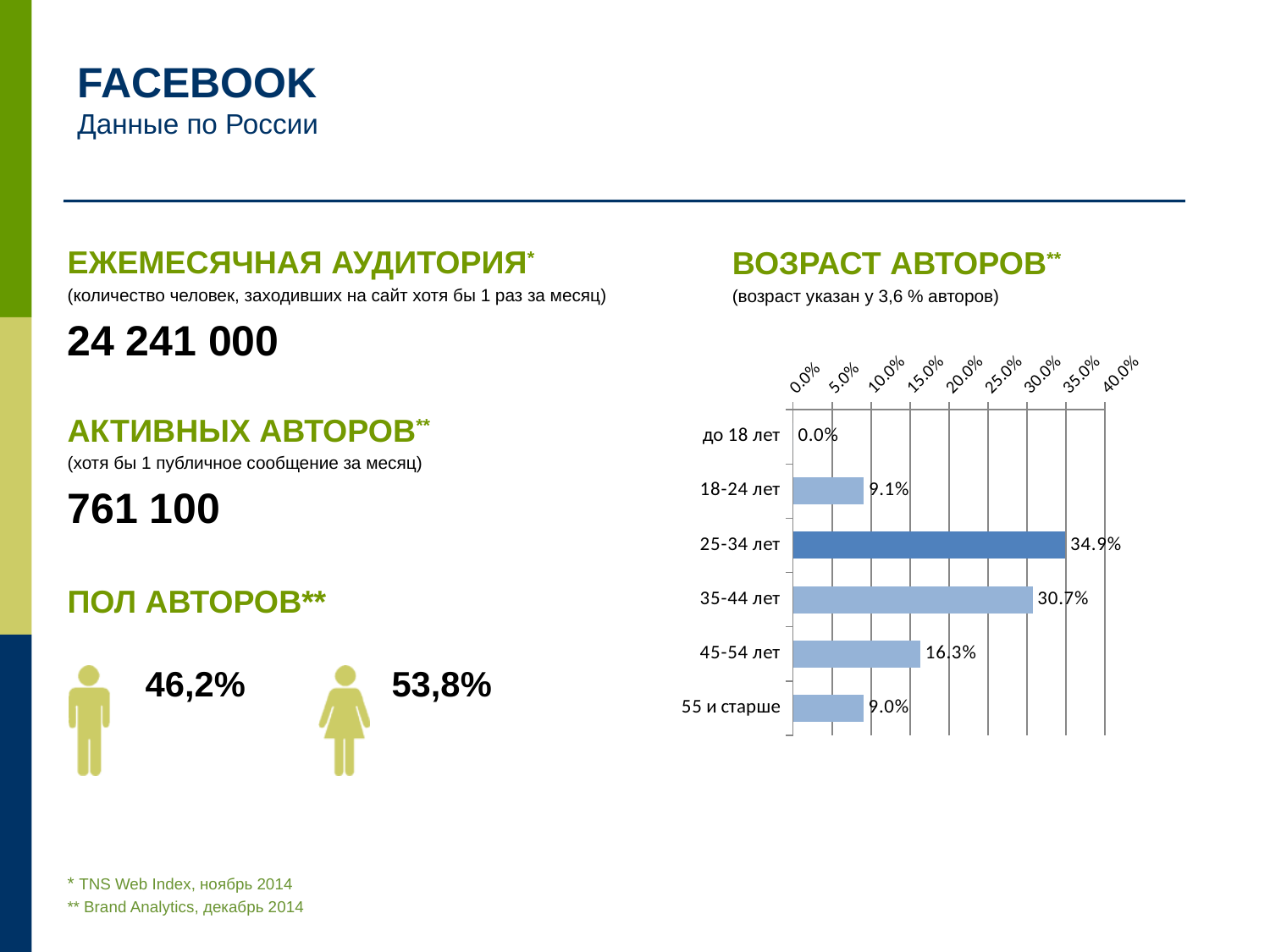
What is the value for the 45-54 лет category in the age chart? 16.3% How many age categories are shown in the chart? 6 Is the value for 35-44 лет greater or less than 25.0%? greater What is the difference between the values for 18-24 лет and 55 и старше? 0.1% What is the value for the 25-34 лет category in the age chart? 34.9% Which age category has the lowest value in the chart? до 18 лет What is the value for the 55 и старше category in the age chart? 9.0% Which age category has the highest value in the chart? 25-34 лет What is the difference between the values for 25-34 лет and 35-44 лет? 4.2% Which is larger: the value for 35-44 лет or the value for 45-54 лет? 35-44 лет What is the title of the chart on the slide? ВОЗРАСТ АВТОРОВ What kind of chart is used to show the age of authors? bar chart